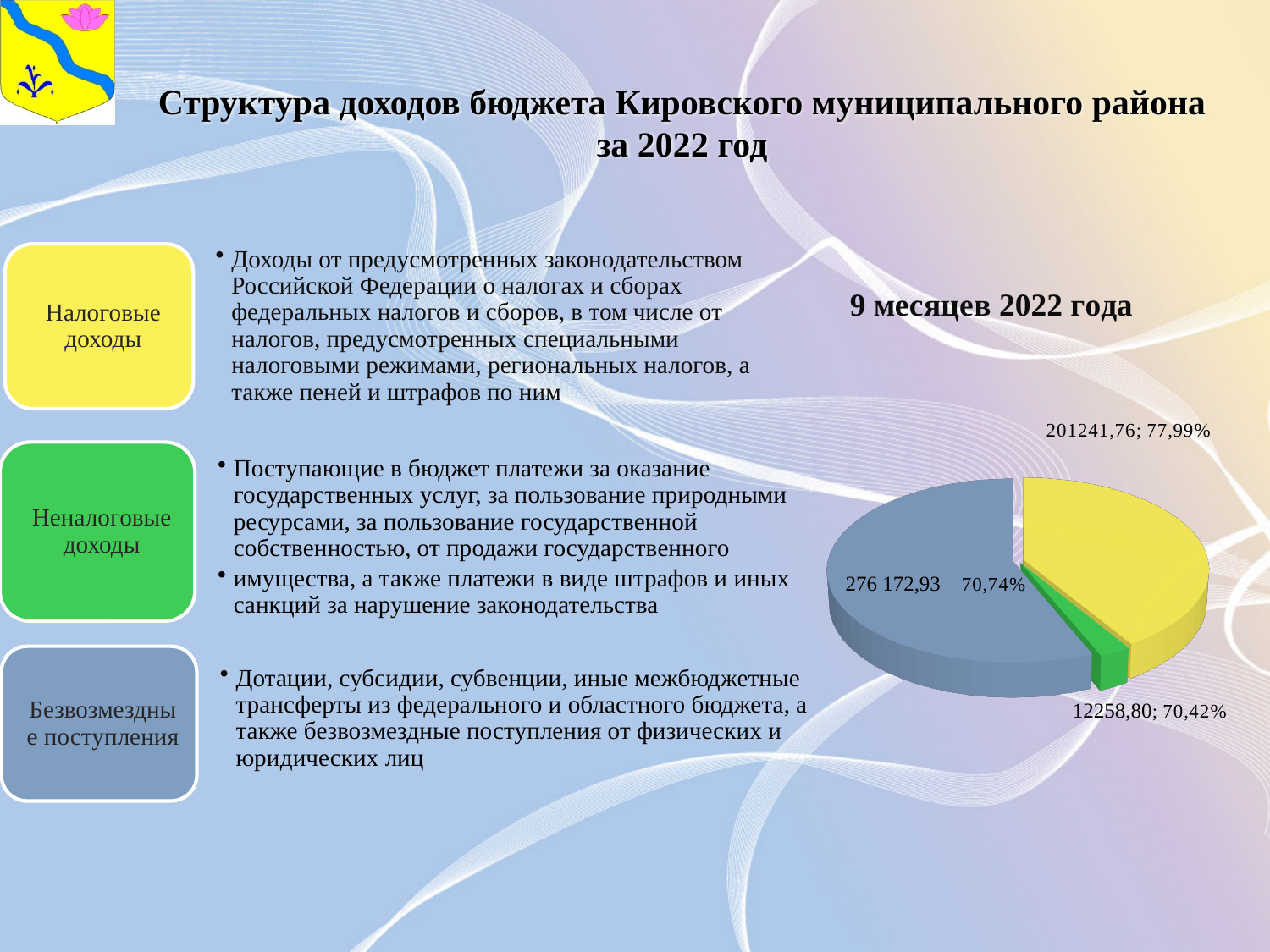
What data label is printed on the blue-grey slice of the pie chart? 276 172,93 70,74% What data label is printed on the yellow slice of the pie chart? 201241,76; 77,99% Which is larger in the pie chart, the yellow slice or the green slice? the yellow slice Which slice of the pie chart is the smallest? the green slice (12258,80) What is the title of the pie chart? 9 месяцев 2022 года What kind of chart is shown on the slide? pie chart What data label is printed for the green slice of the pie chart? 12258,80; 70,42% How many slices does the pie chart have? 3 What percentage is printed next to the yellow slice of the pie chart? 77,99% Which slice of the pie chart is the largest? the blue-grey slice (276 172,93) What colours are the three slices of the pie chart? yellow, green and blue-grey